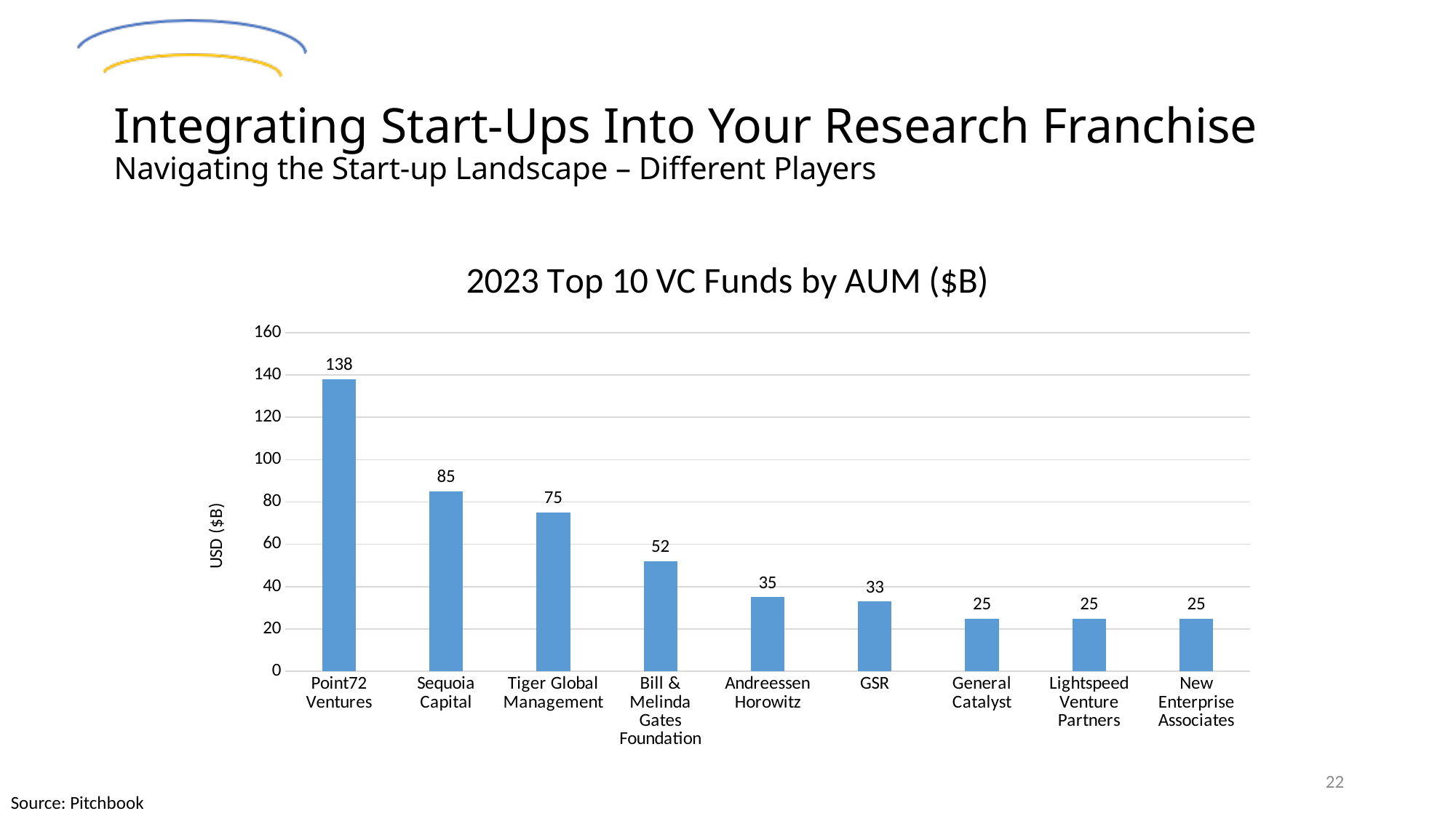
What is the AUM value shown for GSR? 33 How many funds are shown in the chart? 9 What is the AUM value shown for Tiger Global Management? 75 What is the title of the chart? 2023 Top 10 VC Funds by AUM ($B) Which fund has the highest AUM in the chart? Point72 Ventures What kind of chart is shown on the slide? Bar chart Is the value for Tiger Global Management greater or less than 80? less What is the difference between the AUM of Sequoia Capital and Bill & Melinda Gates Foundation? 33 Which has a larger AUM, Andreessen Horowitz or General Catalyst? Andreessen Horowitz What is the AUM value shown for Point72 Ventures? 138 What is the difference between the AUM of Point72 Ventures and Sequoia Capital? 53 Do the values rise or fall from left to right across the chart? Fall